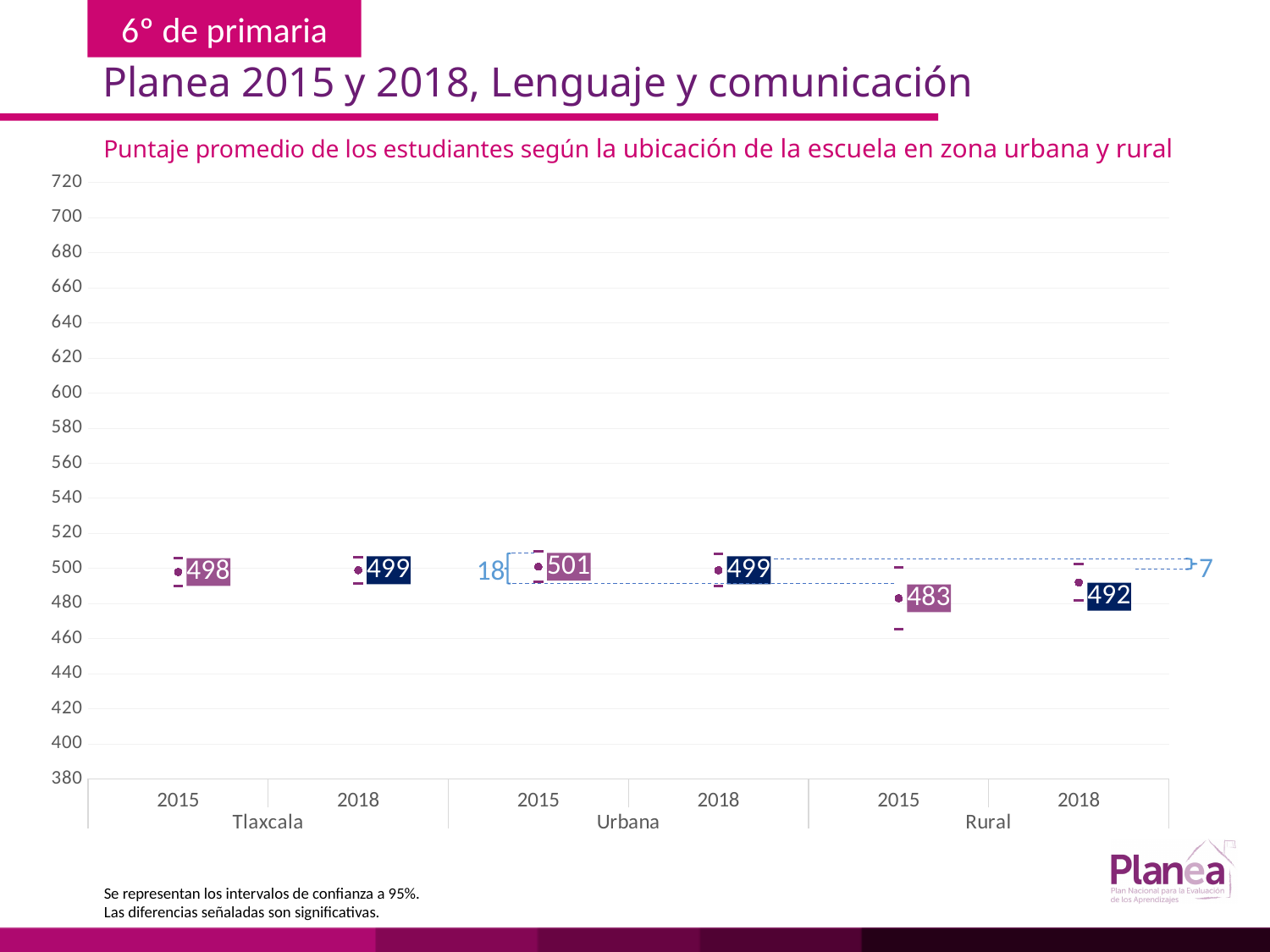
What is the difference between the Urbana and Rural average scores in 2015? 18 What is the average score for Rural schools in 2015? 483 What is the average score for Rural schools in 2018? 492 Which group and year has the lowest average score? Rural 2015 Which is larger, the Rural score in 2015 or the Rural score in 2018? Rural 2018 Which group and year has the highest average score? Urbana 2015 Did the Rural average score rise or fall from 2015 to 2018? rise What is the average score for Tlaxcala in 2015? 498 What is the average score for Urbana schools in 2015? 501 What is the average score for Tlaxcala in 2018? 499 What is the difference between the Urbana and Rural average scores in 2018? 7 How many data points are plotted on the chart? 6